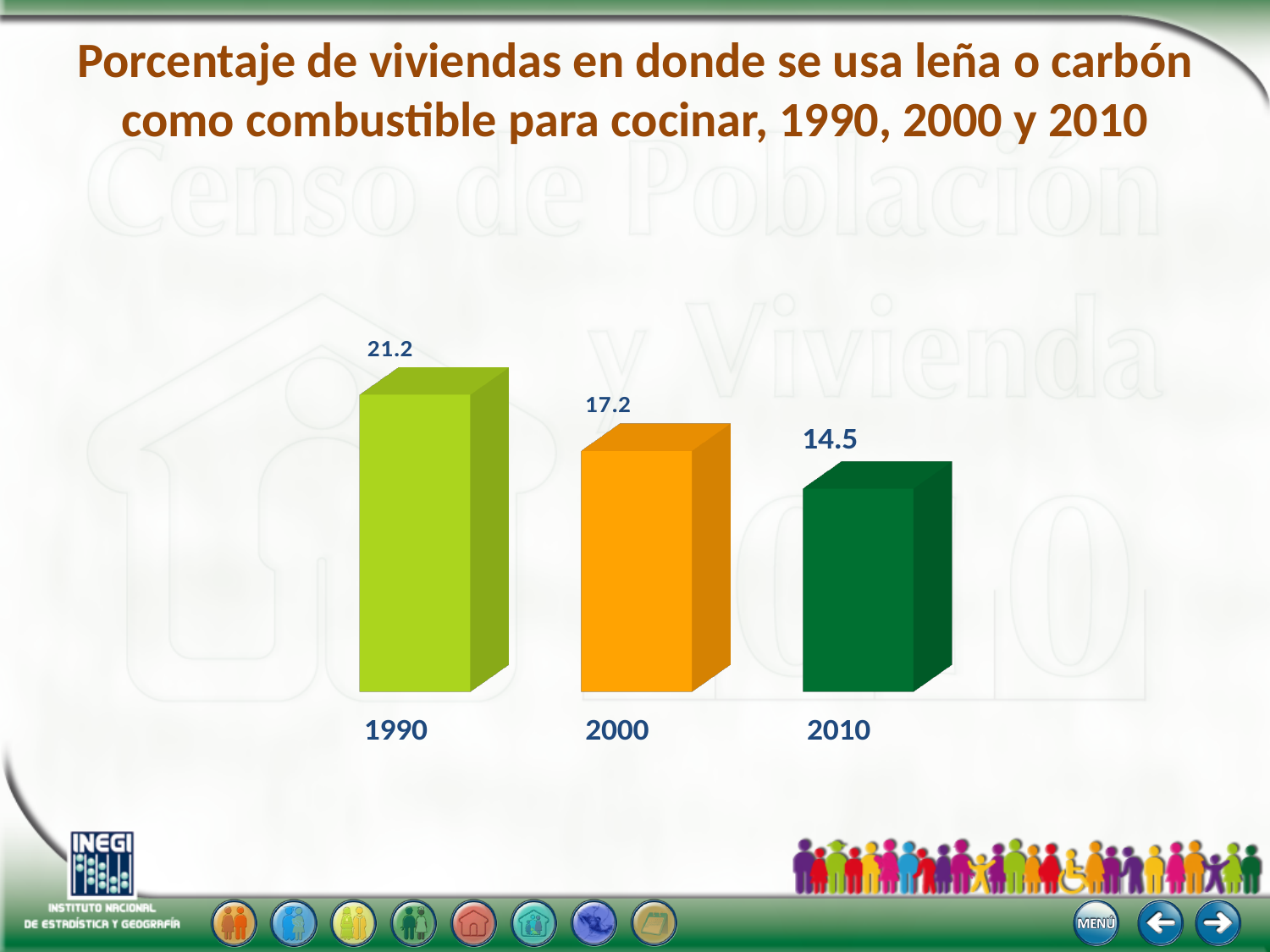
What is the value for 1990? 21.2 How many years are shown in the chart? 3 What colour is the bar for 2000? orange Which year has the highest value? 1990 Which year has the lowest value? 2010 What is the difference between the values for 1990 and 2010? 6.7 Do the values rise or fall from 1990 to 2010? fall What kind of chart is shown on the slide? bar chart What is the value for 2010? 14.5 What is the difference between the values for 1990 and 2000? 4.0 Which is larger, the value for 2000 or the value for 2010? 2000 What is the value for 2000? 17.2